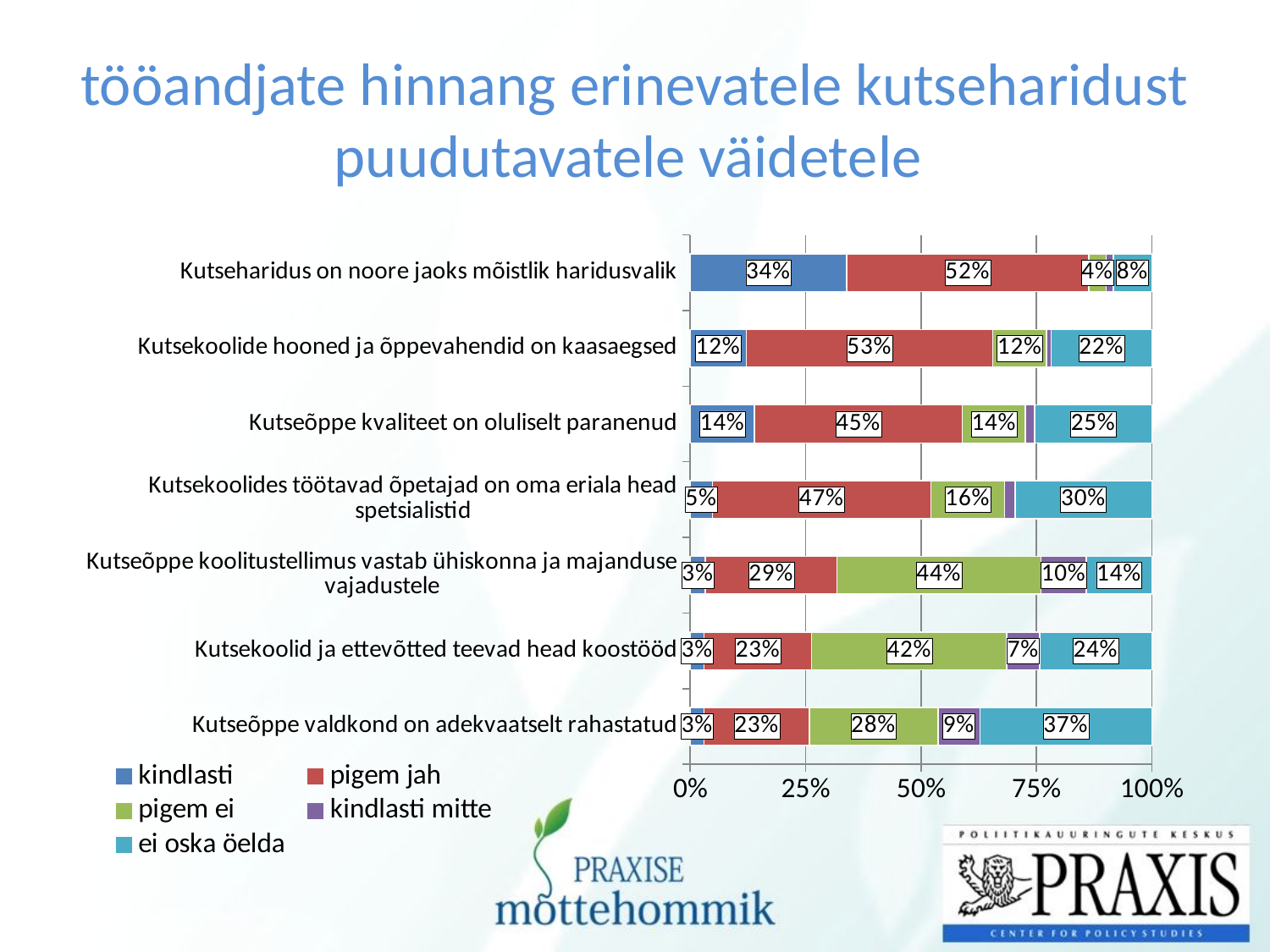
Which is larger: the 'pigem ei' value for 'Kutsekoolid ja ettevõtted teevad head koostööd' or for 'Kutseõppe valdkond on adekvaatselt rahastatud'? Kutsekoolid ja ettevõtted teevad head koostööd Which statement has the lowest 'ei oska öelda' value? Kutseharidus on noore jaoks mõistlik haridusvalik What is the 'kindlasti' value for 'Kutseõppe kvaliteet on oluliselt paranenud'? 14% How many series does the legend list? 5 What kind of chart is shown on the slide? stacked bar chart Which statement has the highest 'kindlasti' value? Kutseharidus on noore jaoks mõistlik haridusvalik What is the 'pigem jah' value for 'Kutsekoolide hooned ja õppevahendid on kaasaegsed'? 53% What is the 'pigem ei' value for 'Kutseõppe koolitustellimus vastab ühiskonna ja majanduse vajadustele'? 44% How many statements (categories) are plotted in the chart? 7 What is the difference between the 'pigem jah' values for 'Kutseharidus on noore jaoks mõistlik haridusvalik' and 'Kutseõppe valdkond on adekvaatselt rahastatud'? 29% Which colour represents the 'kindlasti mitte' series in the legend? purple What is the 'ei oska öelda' value for 'Kutseõppe valdkond on adekvaatselt rahastatud'? 37%